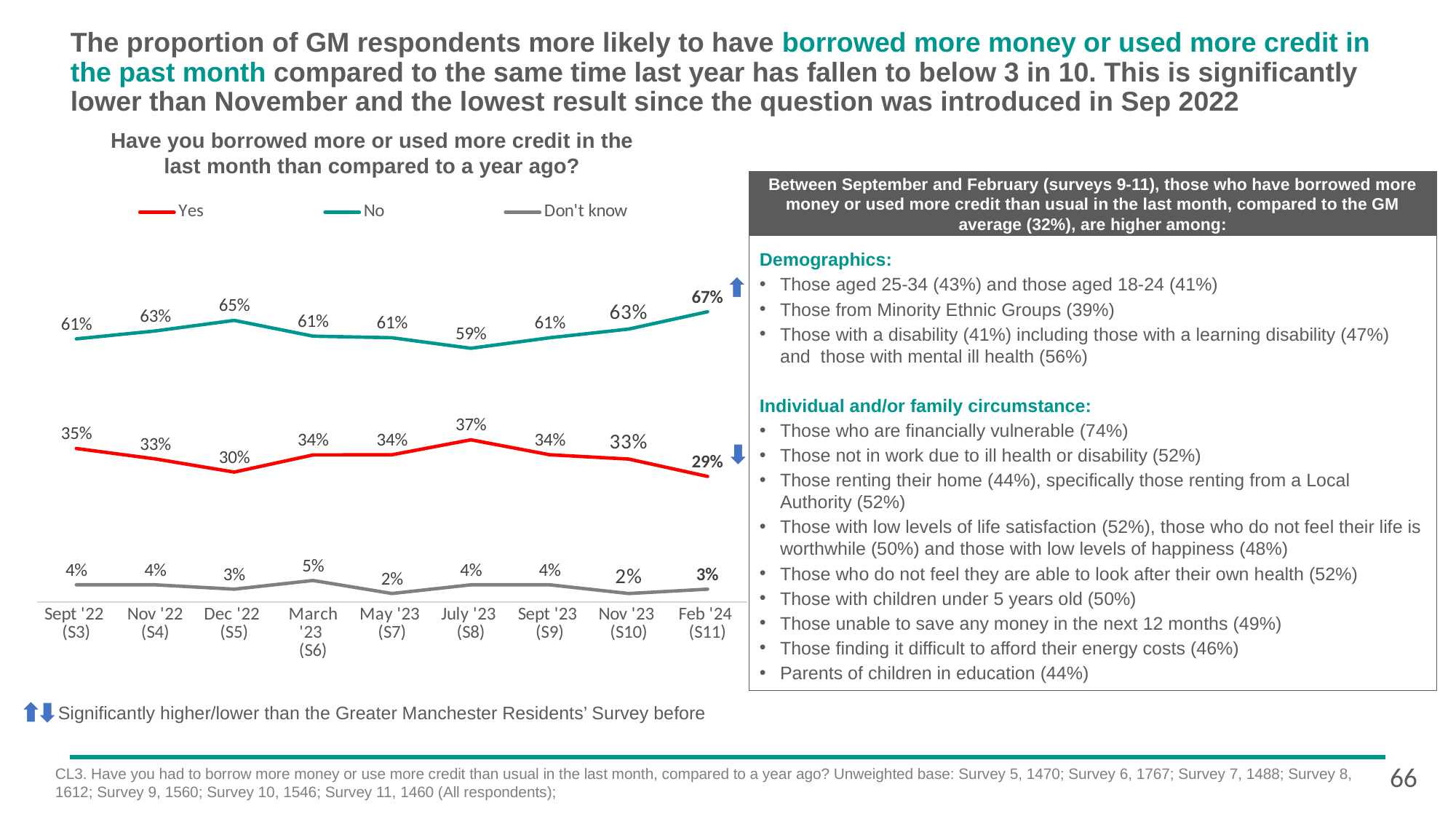
Which was higher for 'Yes': Sept '22 (S3) or Dec '22 (S5)? Sept '22 (S3) What percentage of respondents answered 'Don't know' in March '23 (S6)? 5% By how many percentage points did the 'Yes' value fall from Nov '23 (S10) to Feb '24 (S11)? 4 percentage points In which survey wave was the 'Yes' series at its highest? July '23 (S8) How many series does the chart legend list? 3 What percentage of respondents answered 'No' in July '23 (S8)? 59% What is the difference between the 'No' and 'Yes' values in Feb '24 (S11)? 38 percentage points What type of chart is used to show the survey responses? Line chart What percentage of respondents answered 'Yes' in Feb '24 (S11)? 29% In which survey wave was the 'No' series at its lowest? July '23 (S8) How many survey waves are shown on the x axis of the chart? 9 What colour is the 'Yes' line in the chart? Red